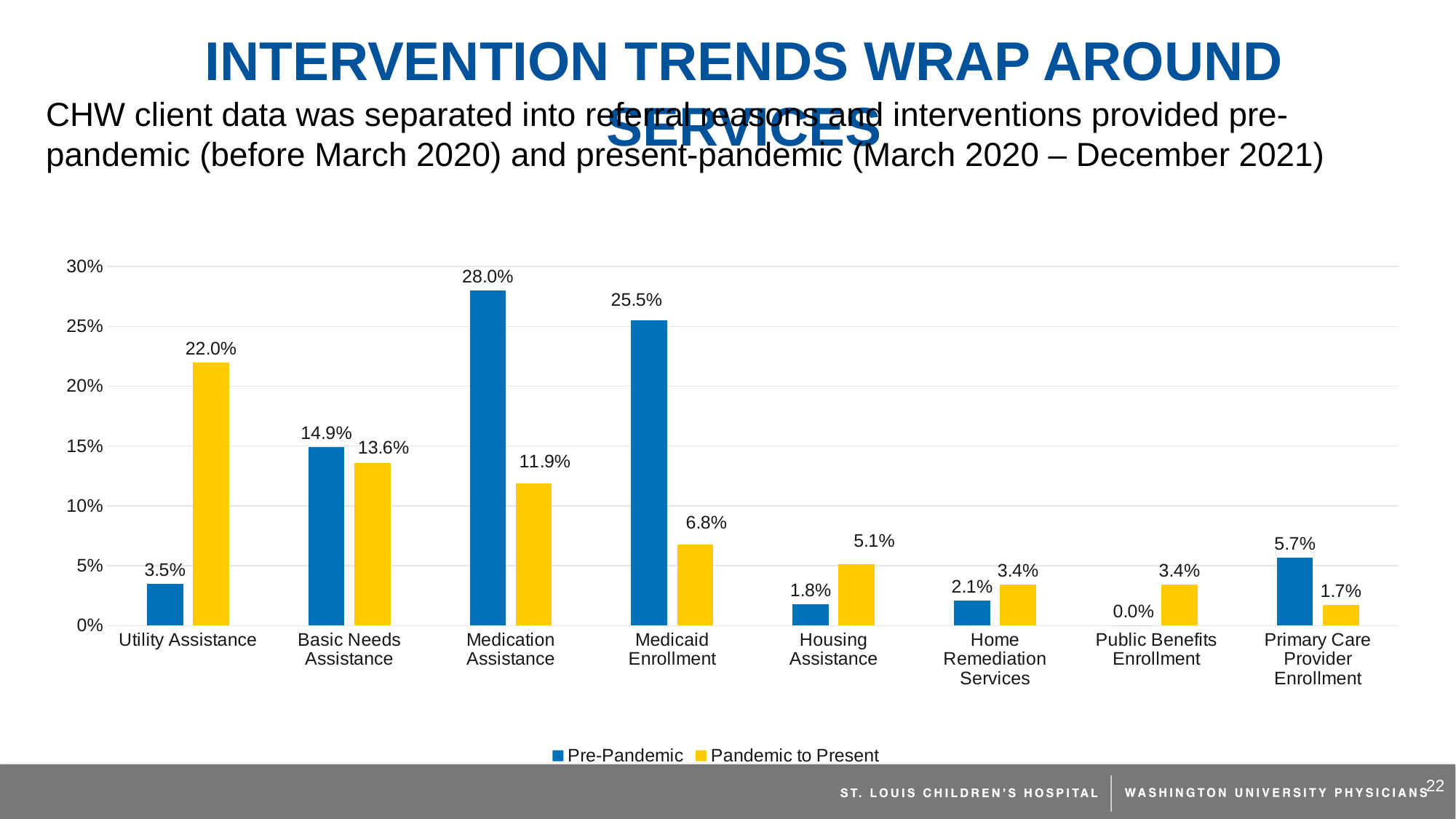
Is the Pre-Pandemic value for Basic Needs Assistance greater or less than 10%? greater What kind of chart is shown on the slide? Bar chart Which is larger for Housing Assistance: the Pre-Pandemic value or the Pandemic to Present value? Pandemic to Present What is the Pre-Pandemic value for Public Benefits Enrollment? 0.0% Which category has the highest Pre-Pandemic value? Medication Assistance Which colour represents the Pandemic to Present series? Yellow Which category has the lowest Pandemic to Present value? Primary Care Provider Enrollment How many series does the legend list? 2 How many categories are shown on the x axis? 8 What is the Pre-Pandemic value for Medication Assistance? 28.0% What is the difference between the Pre-Pandemic and Pandemic to Present values for Medicaid Enrollment? 18.7% What is the Pandemic to Present value for Utility Assistance? 22.0%